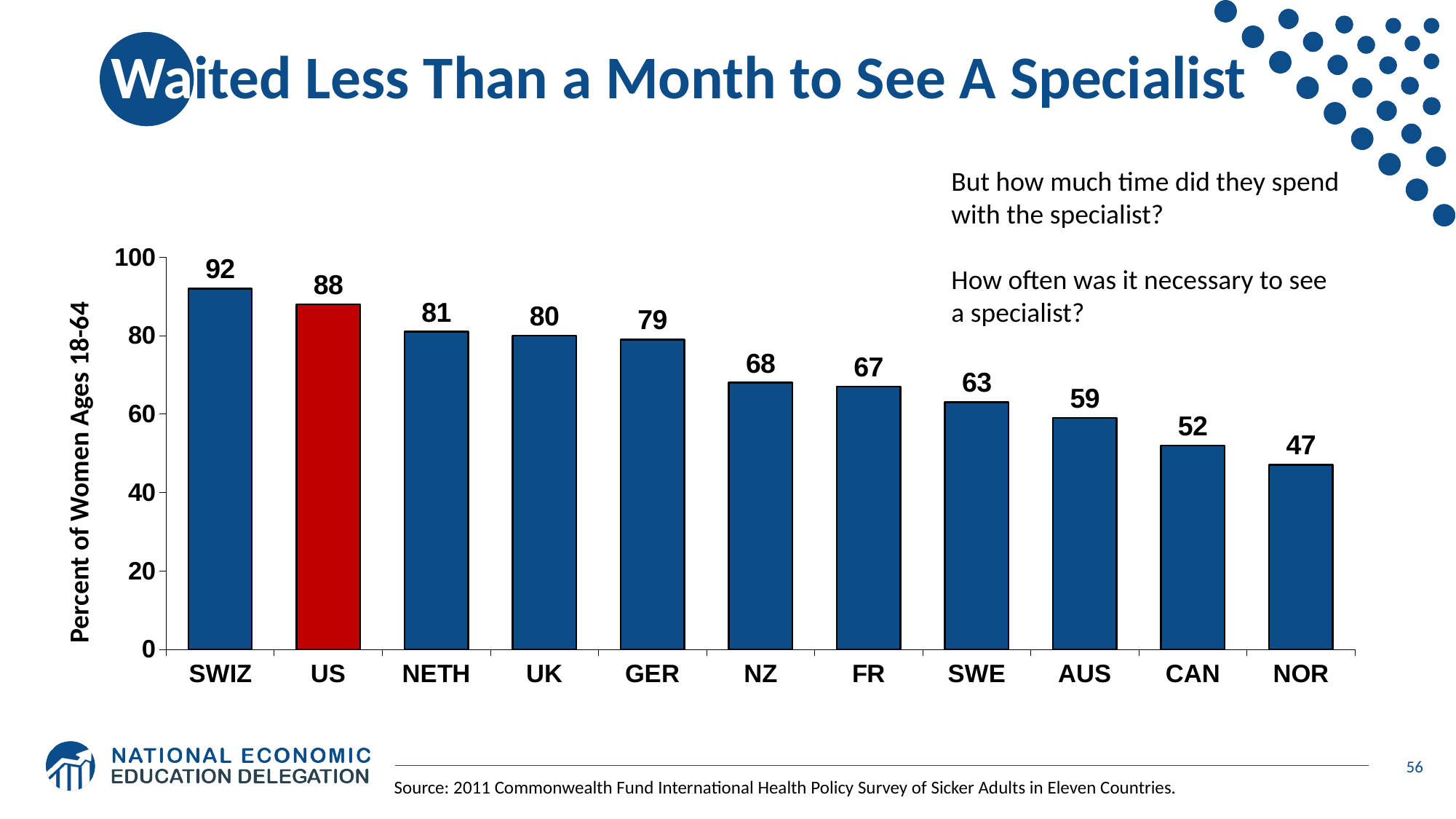
Which is larger, the value for NZ or the value for SWE? NZ What is the value for the US? 88 What is the difference between the values for CAN and NOR? 5 What is the value for NOR? 47 Which country has the highest value? SWIZ Which country has the lowest value? NOR What is the value for GER? 79 What kind of chart is shown on the slide? bar chart How many countries are shown on the chart? 11 Is the value for AUS greater or less than 60? less What is the difference between the values for SWIZ and the US? 4 Which country's bar is coloured red? US